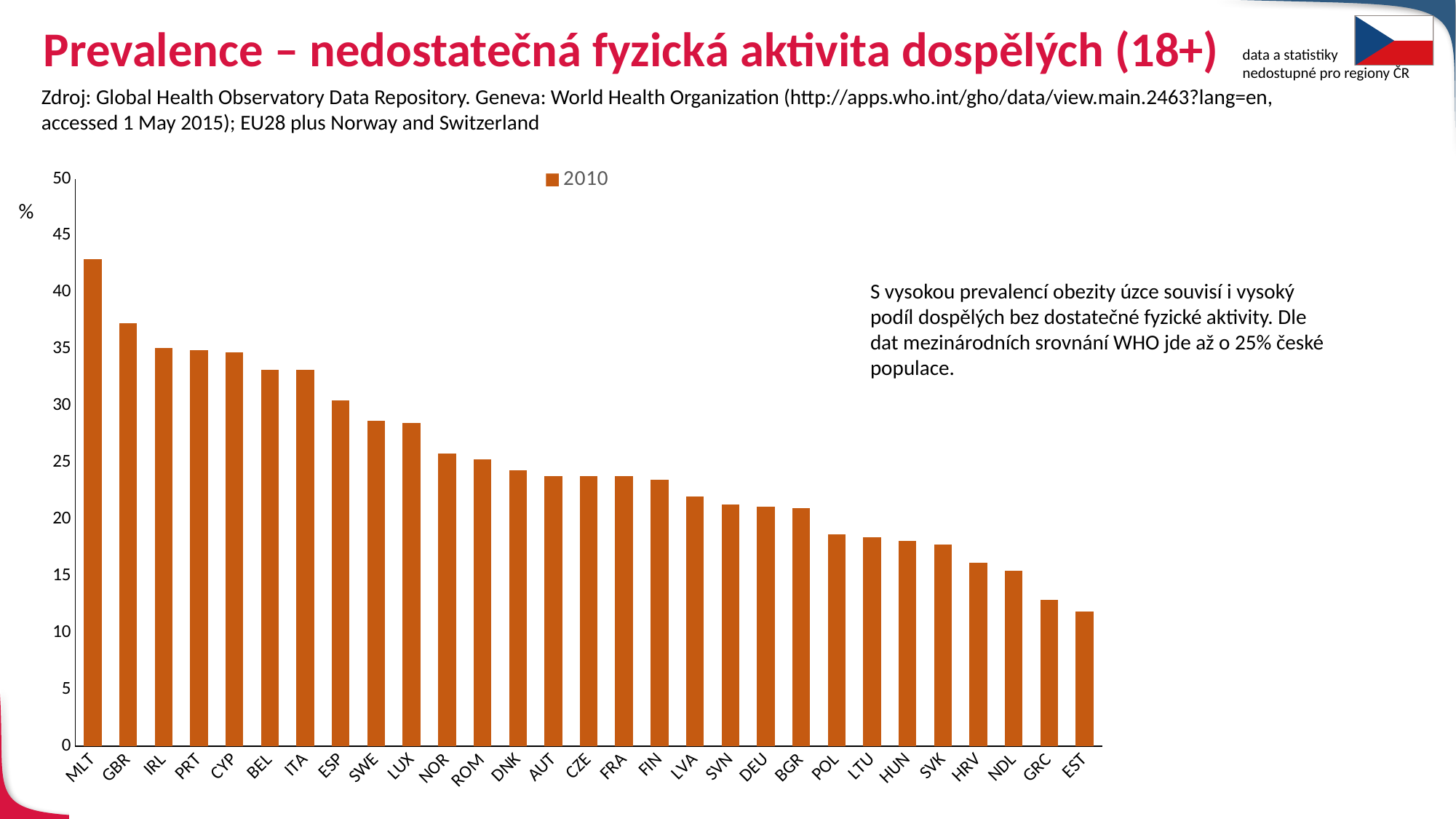
Do the values rise or fall moving from left to right along the x axis? fall How many countries are shown on the x axis of the chart? 29 What year does the chart legend show? 2010 Is the value for EST greater or less than 15? less Which country has the highest value in the chart? MLT Which has a larger value, GBR or IRL? GBR What kind of chart is shown on the slide? bar chart Which country has the lowest value in the chart? EST How many series does the chart legend list? 1 Is the value for CZE greater or less than 25? less Is the value for MLT greater or less than 40? greater